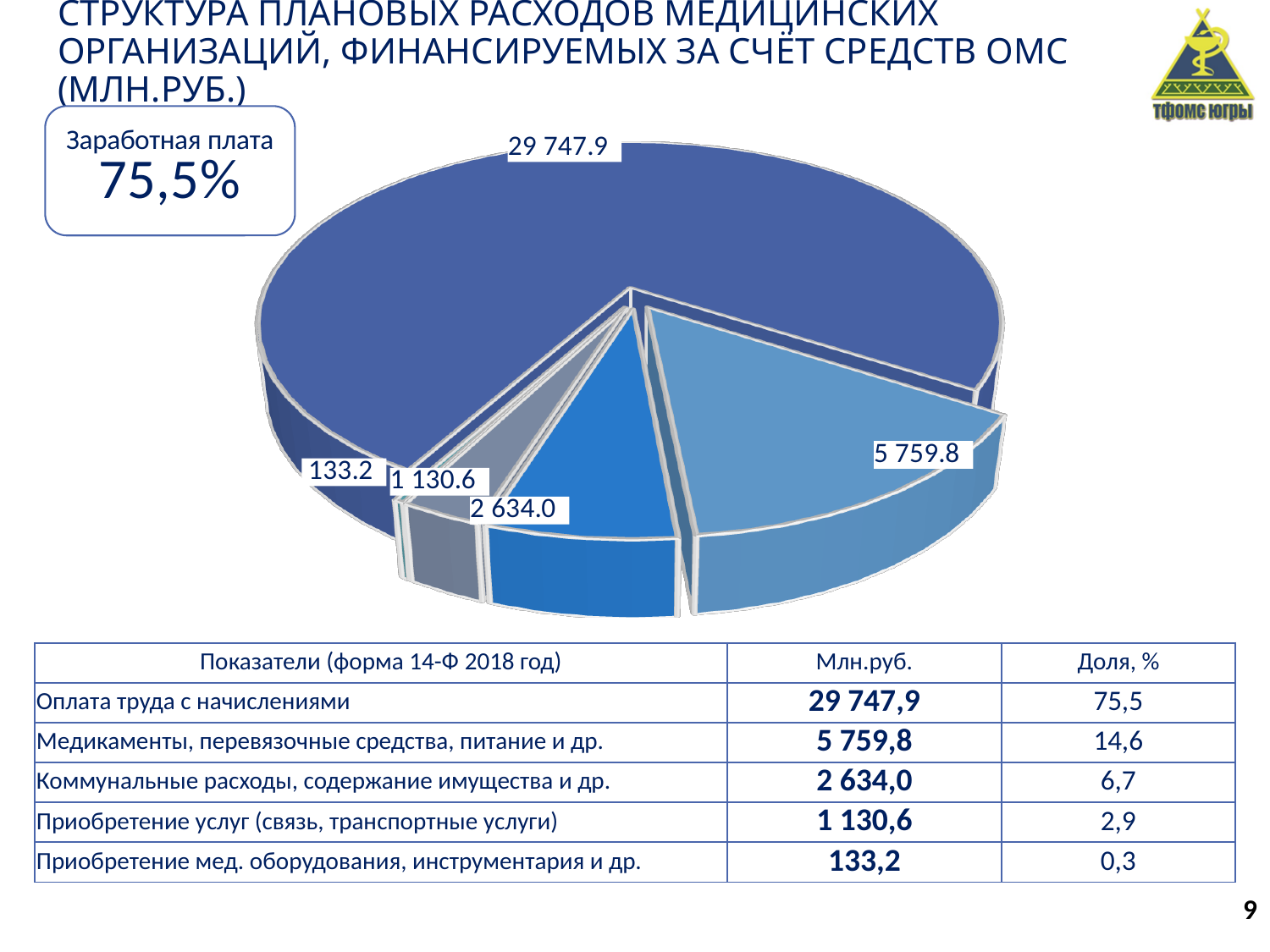
What is the difference between the largest slice (29 747.9) and the second largest slice (5 759.8)? 23 988.1 How many slices does the pie chart have? 5 What value is shown on the pie chart for Медикаменты, перевязочные средства, питание и др.? 5 759.8 What is the value of the largest slice of the pie chart? 29 747.9 According to the table, which category does the largest slice (29 747.9) correspond to? Оплата труда с начислениями Which slice is larger: the one labelled 2 634.0 or the one labelled 1 130.6? 2 634.0 What is the value of the smallest slice of the pie chart? 133.2 What percentage is shown in the callout box labelled Заработная плата next to the chart? 75,5% What kind of chart is shown on the slide? pie chart What is the sum of all five slice values shown on the pie chart? 39 405.5 What value is shown on the pie chart for Коммунальные расходы, содержание имущества и др.? 2 634.0 What share of the total does the slice labelled 5 759.8 represent, according to the table? 14,6